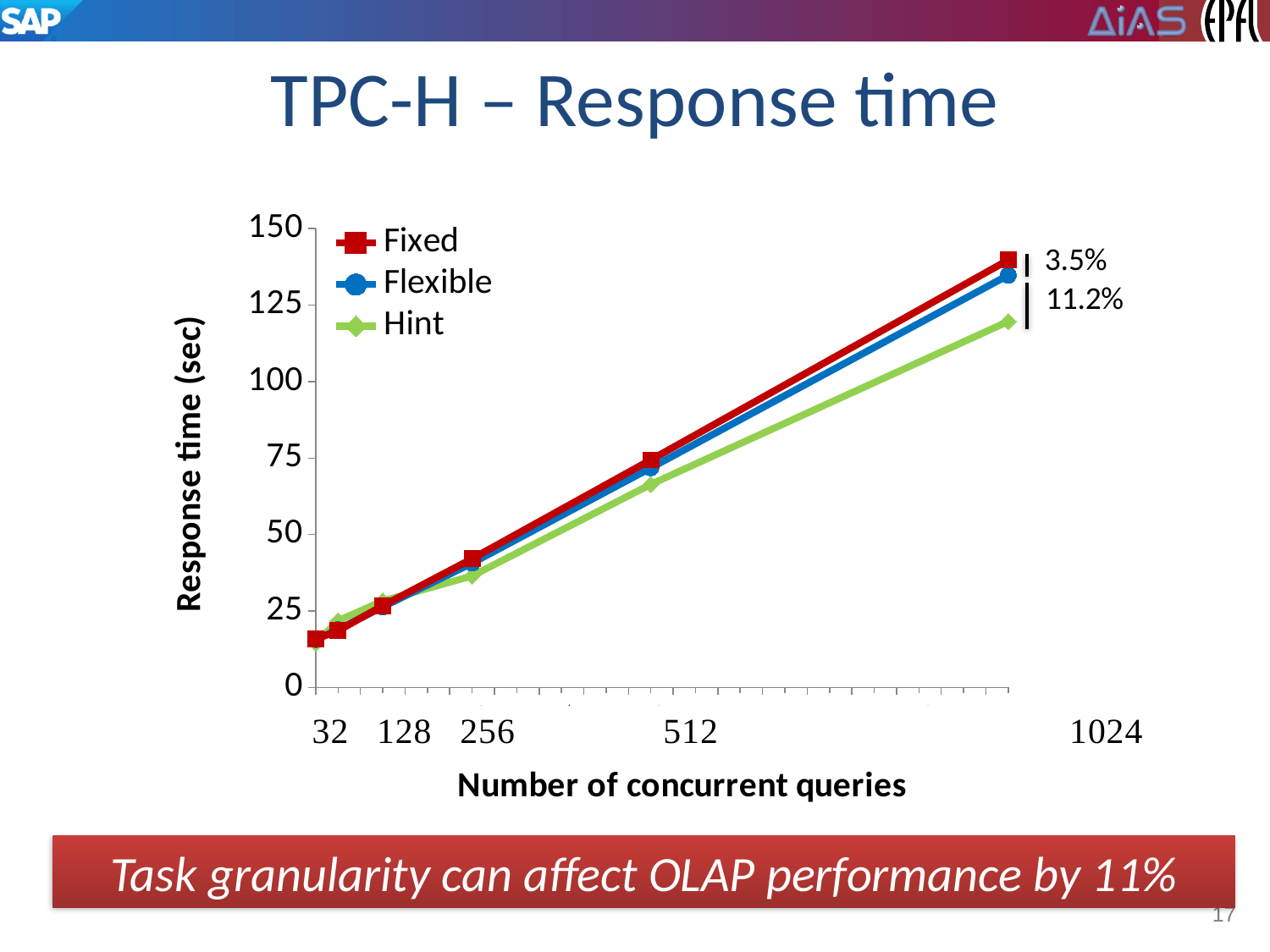
How many values are labeled on the x axis (Number of concurrent queries)? 5 Is the response time for Fixed at 512 concurrent queries greater or less than 100 sec? less At 1024 concurrent queries, which is larger: the response time for Fixed or for Hint? Fixed What kind of chart is shown on the slide? Line chart How many series does the legend list? 3 Which series has the highest response time at 1024 concurrent queries? Fixed Which series has the lowest response time at 1024 concurrent queries? Hint Is the response time for Hint at 1024 concurrent queries greater or less than 100 sec? greater Is the response time for Hint at 256 concurrent queries greater or less than 50 sec? less Do the response times rise or fall as the number of concurrent queries increases? Rise